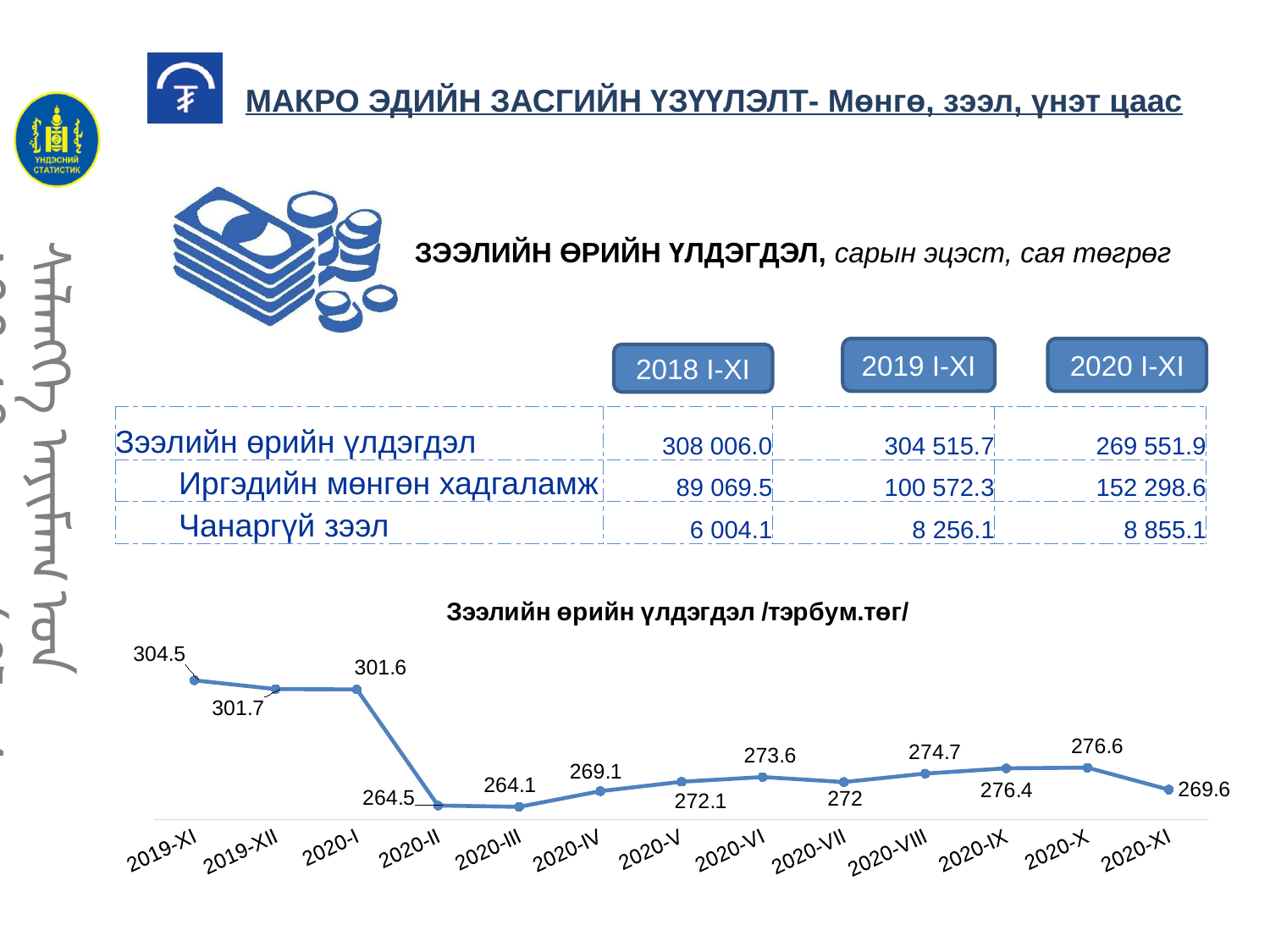
What is the difference between the values for 2020-I and 2020-II? 37.1 What is the value for 2020-XI? 269.6 What is the value for 2020-X? 276.6 What is the value for 2020-II? 264.5 What type of chart is shown on the slide? line chart Do the values rise or fall from 2020-III to 2020-X? rise What is the title of the chart? Зээлийн өрийн үлдэгдэл /тэрбум.төг/ Which month has the highest value? 2019-XI What is the value for 2020-VI? 273.6 How many data points are plotted on the chart? 13 What is the value for 2019-XI? 304.5 Which is larger, the value for 2020-IX or the value for 2020-XI? 2020-IX